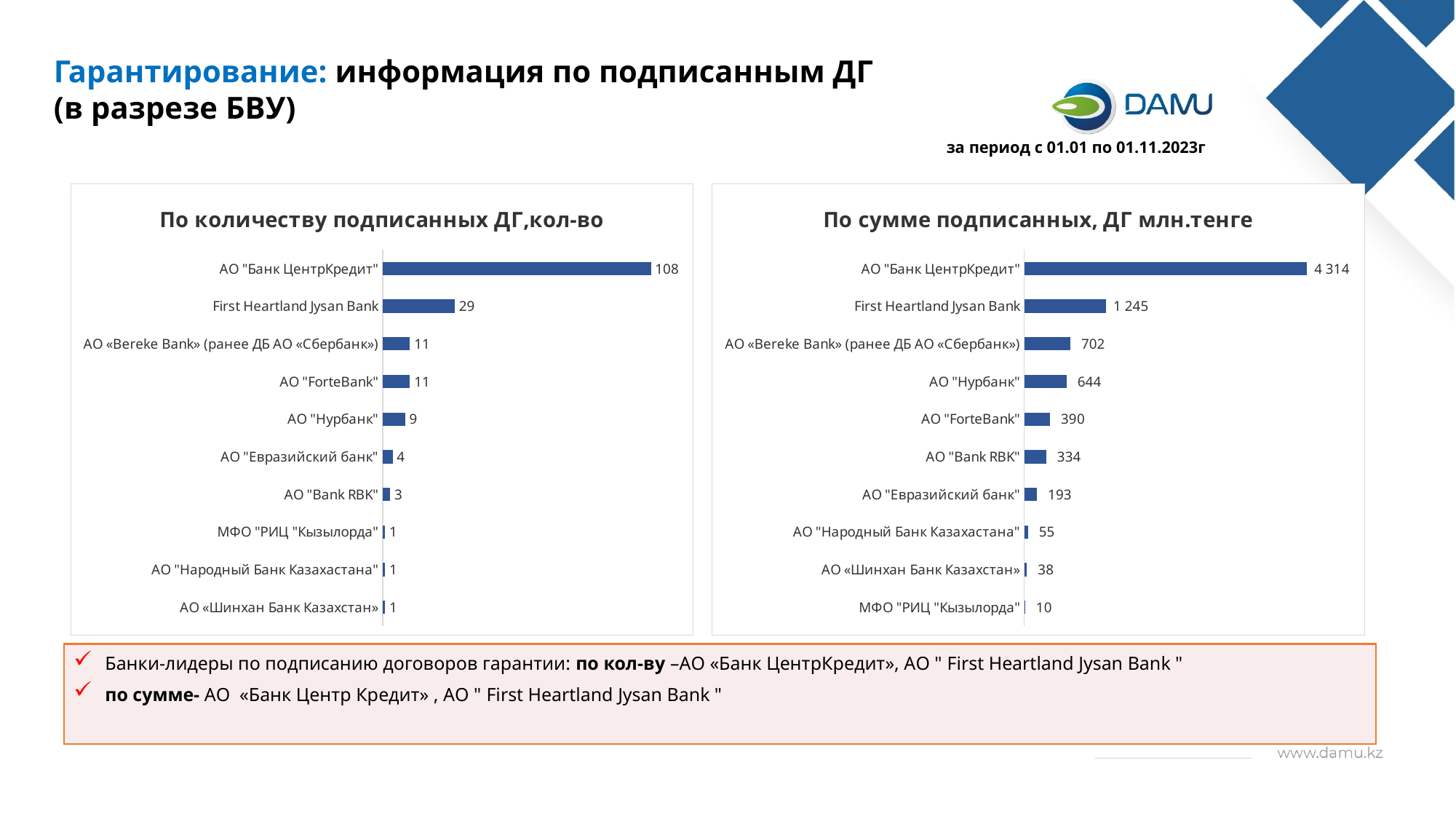
How many banks are shown in the chart "По количеству подписанных ДГ,кол-во"? 10 In the chart "По сумме подписанных, ДГ млн.тенге", which is larger: АО "Bank RBK" or АО "Евразийский банк"? АО "Bank RBK" In the chart "По сумме подписанных, ДГ млн.тенге", which bank has the highest value? АО "Банк ЦентрКредит" In the chart "По количеству подписанных ДГ,кол-во", what is the value for First Heartland Jysan Bank? 29 In the chart "По количеству подписанных ДГ,кол-во", what is the difference between АО "Банк ЦентрКредит" and First Heartland Jysan Bank? 79 What period do the charts on the slide cover? с 01.01 по 01.11.2023г In the chart "По количеству подписанных ДГ,кол-во", what is the value for АО "Евразийский банк"? 4 In the chart "По сумме подписанных, ДГ млн.тенге", which bank has the lowest value? МФО "РИЦ "Кызылорда" In the chart "По сумме подписанных, ДГ млн.тенге", what is the difference between АО «Bereke Bank» (ранее ДБ АО «Сбербанк») and АО "ForteBank"? 312 In the chart "По сумме подписанных, ДГ млн.тенге", what is the value for АО "Нурбанк"? 644 What type of chart is "По сумме подписанных, ДГ млн.тенге"? Bar chart In the chart "По количеству подписанных ДГ,кол-во", which bank has the lowest value among those with a value above 1? АО "Bank RBK"